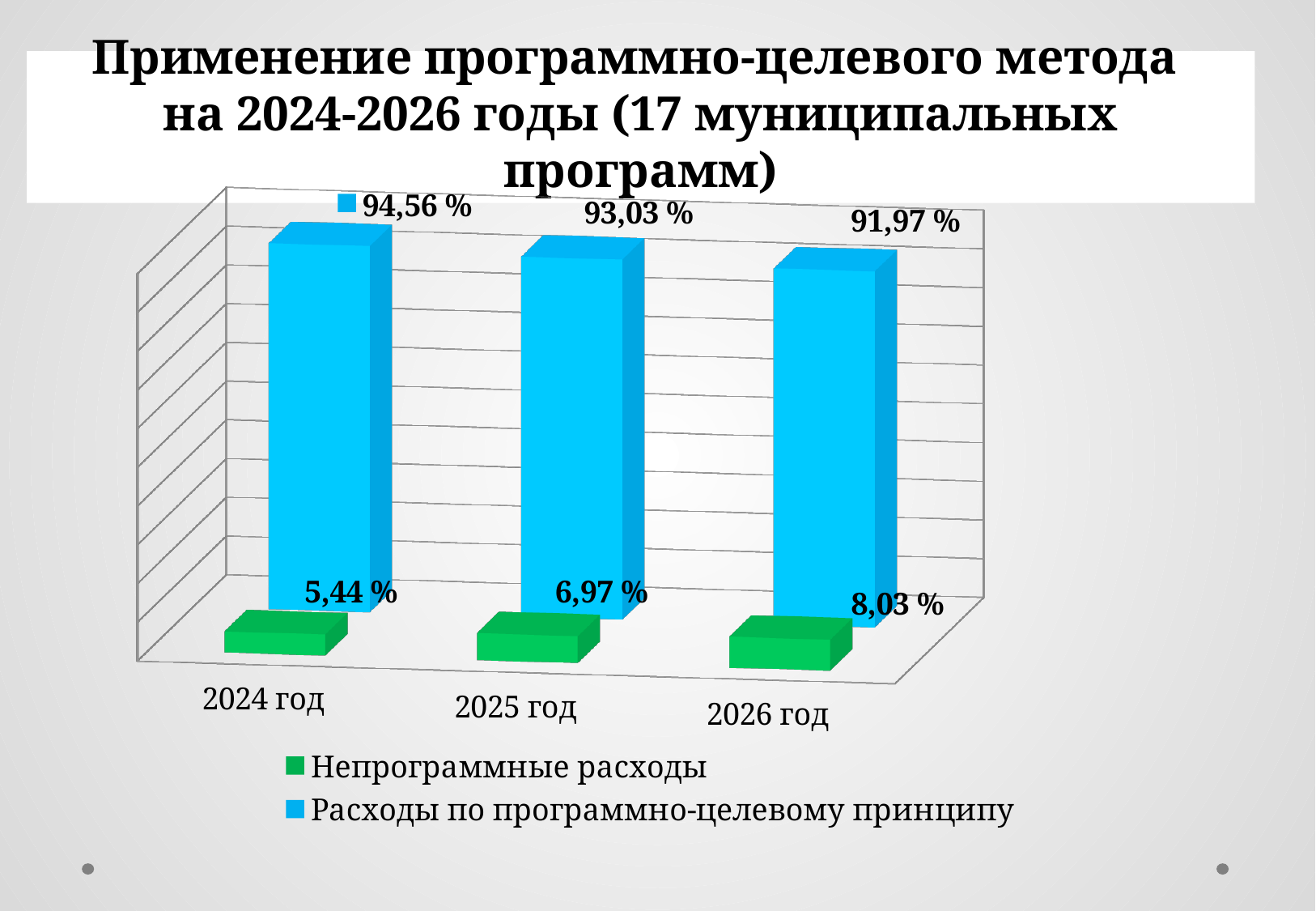
What is the value for "Непрограммные расходы" in 2026 год? 8,03 % In which year is "Расходы по программно-целевому принципу" the highest? 2024 год How many years are shown on the x axis? 3 Which is larger: "Непрограммные расходы" in 2025 год or in 2026 год? 2026 год Do the values for "Расходы по программно-целевому принципу" rise or fall from 2024 год to 2026 год? Fall In which year is "Непрограммные расходы" the lowest? 2024 год What kind of chart is shown on the slide? Bar chart What is the difference between "Расходы по программно-целевому принципу" in 2024 год and 2026 год? 2,59 % What is the value for "Непрограммные расходы" in 2025 год? 6,97 % What is the value for "Расходы по программно-целевому принципу" in 2024 год? 94,56 % How many series does the legend list? 2 Which colour represents "Непрограммные расходы" in the legend? Green